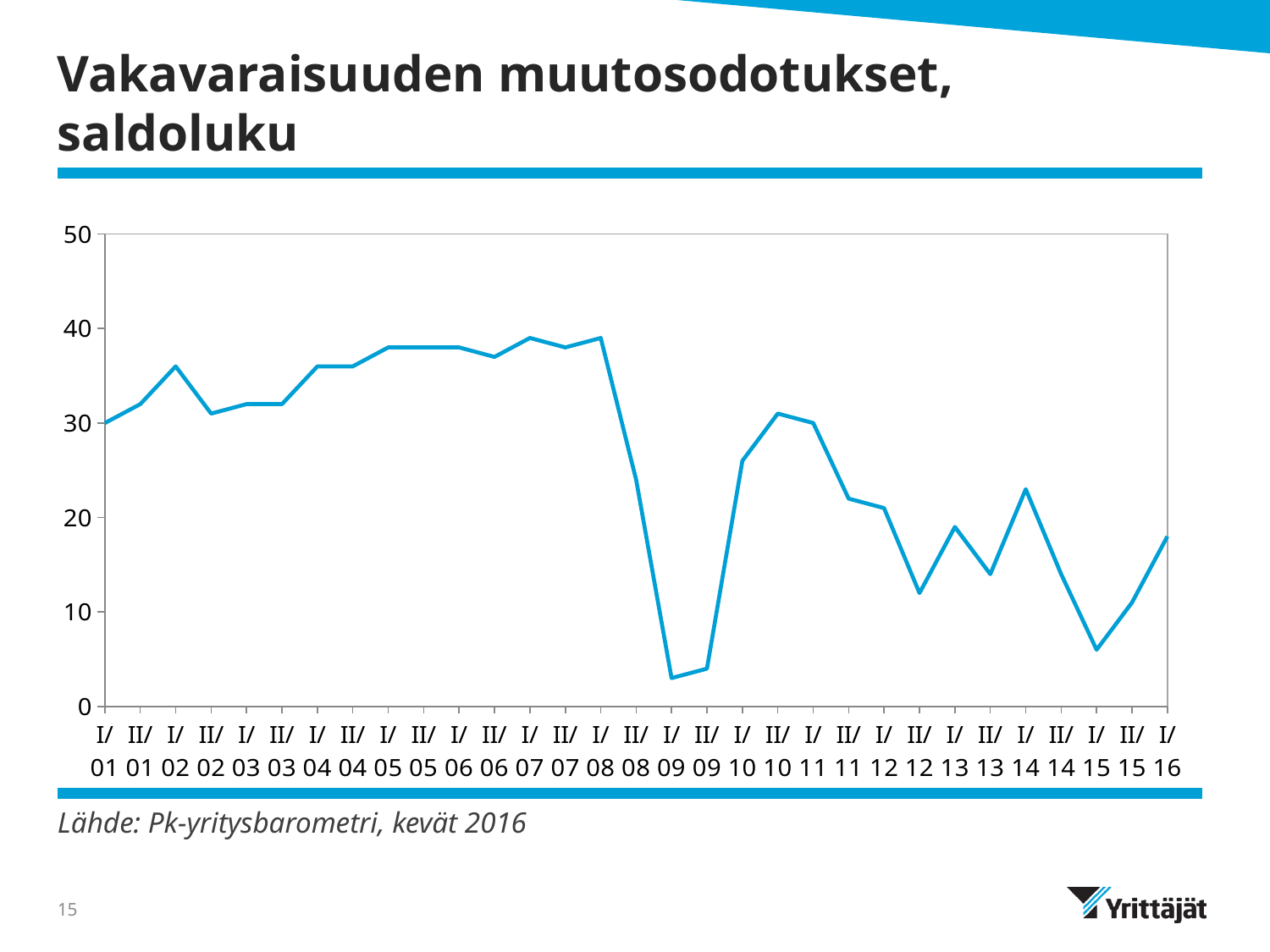
Is the value for I/09 greater or less than 10? less Is the value for I/05 greater or less than 30? greater Which period has the lowest value on the chart? I/09 What kind of chart is shown on the slide? line chart Does the line rise or fall between I/08 and I/09? fall Is the value for I/15 greater or less than 10? less How many data points are plotted on the chart? 31 What is the title of the slide? Vakavaraisuuden muutosodotukset, saldoluku Which is larger, the value for I/02 or the value for II/02? I/02 Which is larger, the value for I/14 or the value for I/15? I/14